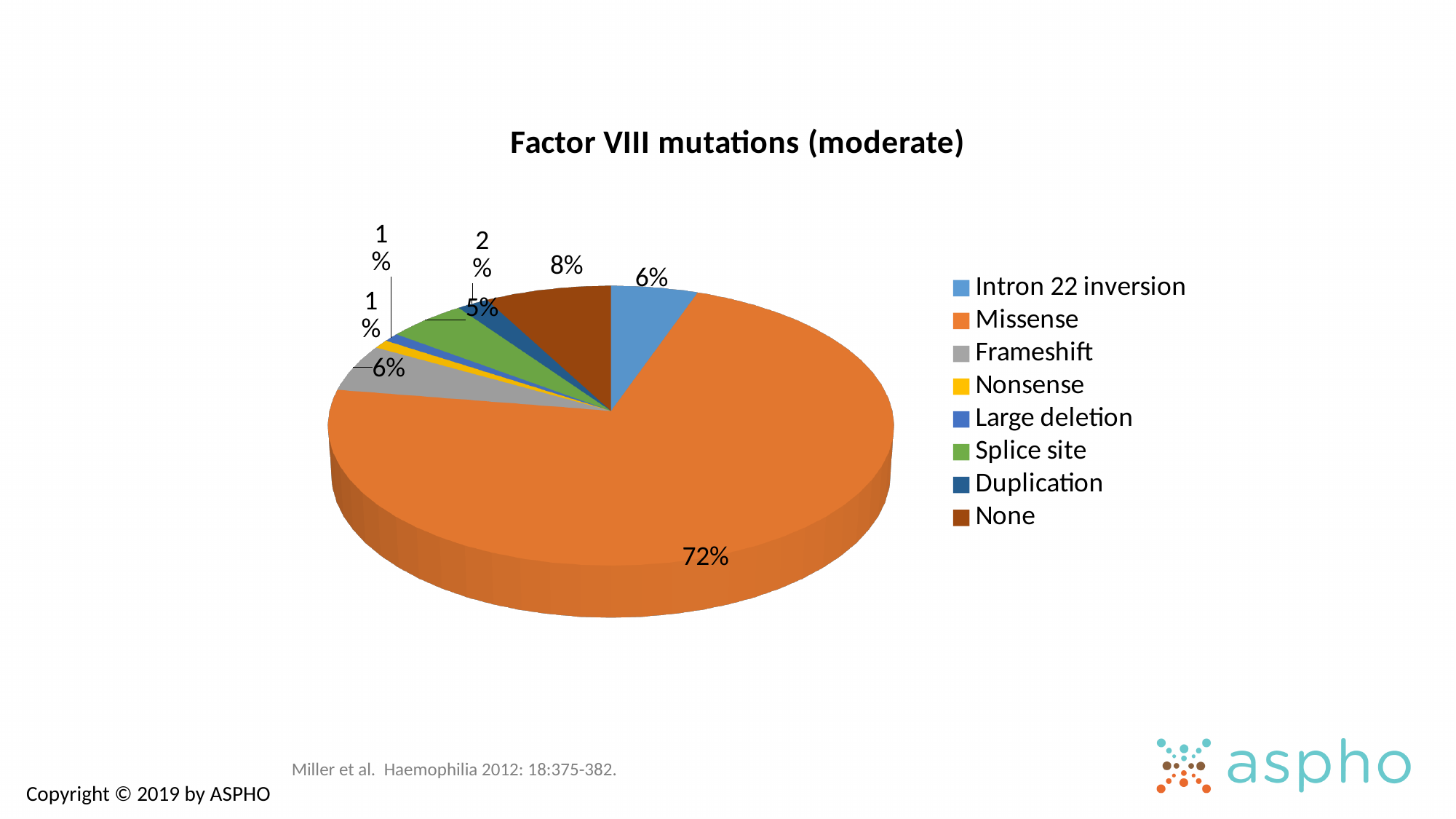
What percentage is shown for Intron 22 inversion? 6% What is the title of the chart? Factor VIII mutations (moderate) What is the difference in percentage points between the None slice and the Splice site slice? 3% What type of chart is shown on the slide? Pie chart Which slice is larger, None or Intron 22 inversion? None What percentage is shown for Duplication? 2% What is the value shown for the None slice? 8% Which slice is larger, Splice site or Duplication? Splice site What percentage is shown for Splice site? 5% Which mutation category has the largest slice of the pie? Missense How many mutation categories are listed in the legend? 8 What percentage of the pie does Missense account for? 72%